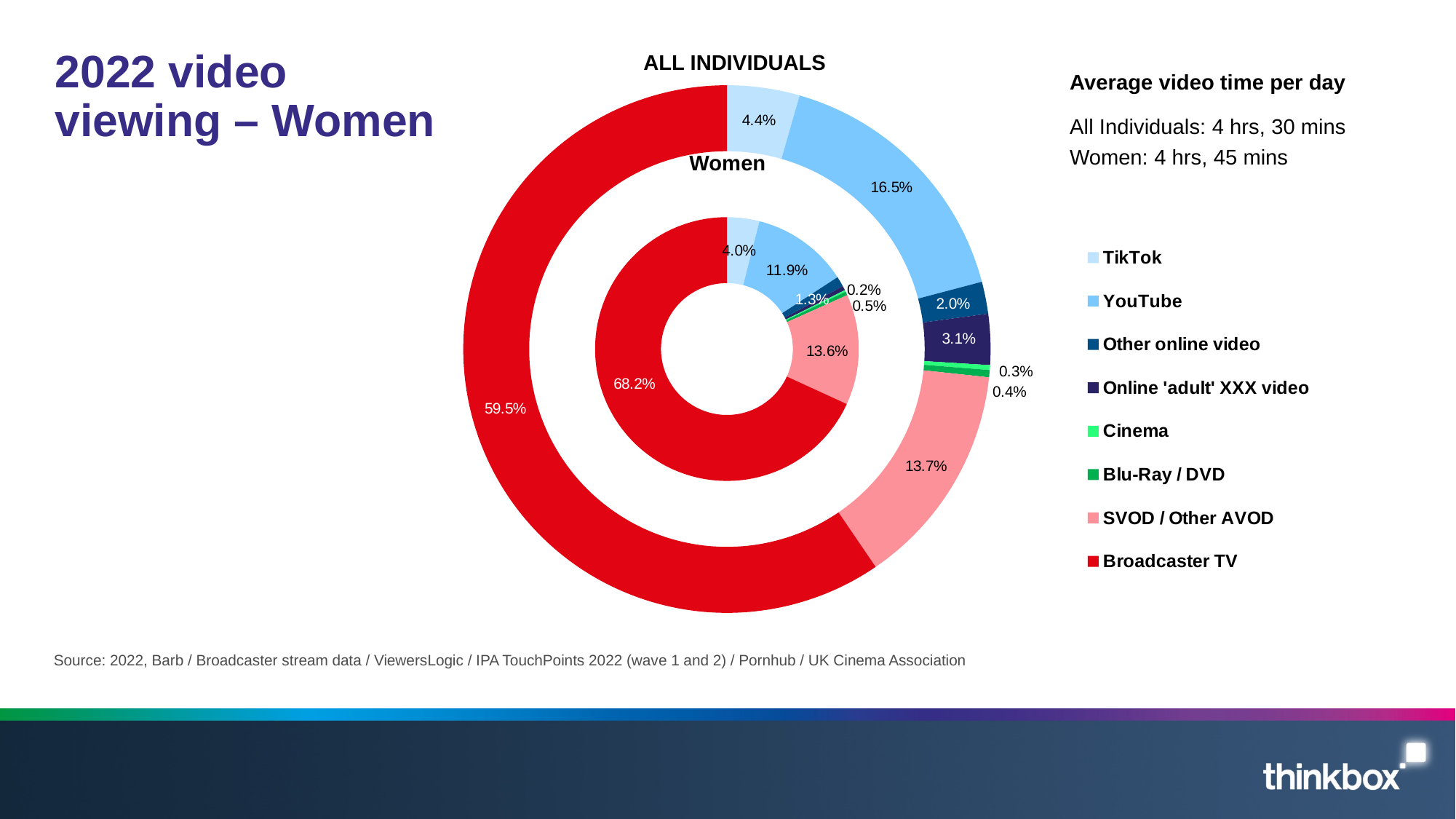
Which category has the largest share in the Women ring? Broadcaster TV What is the SVOD / Other AVOD share for Women? 13.6% How many categories does the legend list? 8 What is the YouTube share for Women? 11.9% How many percentage points higher is the Broadcaster TV share for Women than for All Individuals? 8.7 percentage points What is the YouTube share for All Individuals? 16.5% What type of chart is shown on the slide? Doughnut (pie) chart How many percentage points higher is the YouTube share for All Individuals than for Women? 4.6 percentage points What is the Online 'adult' XXX video share for All Individuals? 3.1% What share of video viewing for Women is Broadcaster TV? 68.2% What share of video viewing for All Individuals is Broadcaster TV? 59.5% For All Individuals, which is larger: the YouTube share or the SVOD / Other AVOD share? YouTube